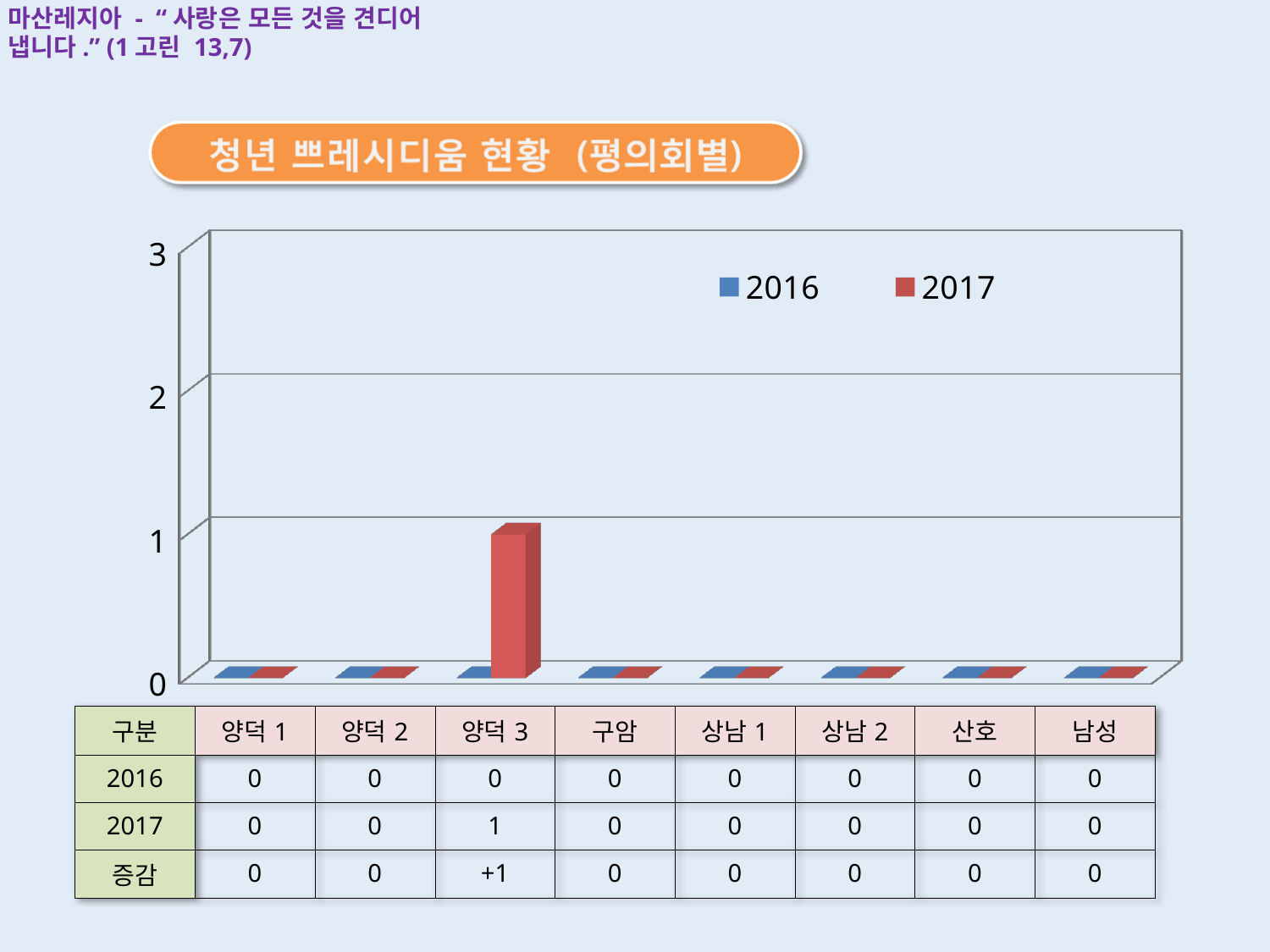
What is the 2016 value for 양덕 3? 0 What is the difference between the 2017 and 2016 values for 양덕 3? 1 What is the 2017 value for 구암? 0 Which is larger for 양덕 3, the 2016 value or the 2017 value? 2017 Which category has the highest 2017 value? 양덕 3 What is the title of the chart? 청년 쁘레시디움 현황 (평의회별) Which colour represents the 2017 series in the chart? red What kind of chart is shown on the slide? bar chart What is the 2017 value for 양덕 3? 1 How many categories are shown along the x axis of the chart? 8 Is the 2017 value for 양덕 3 greater or less than 2? less How many series does the chart legend list? 2